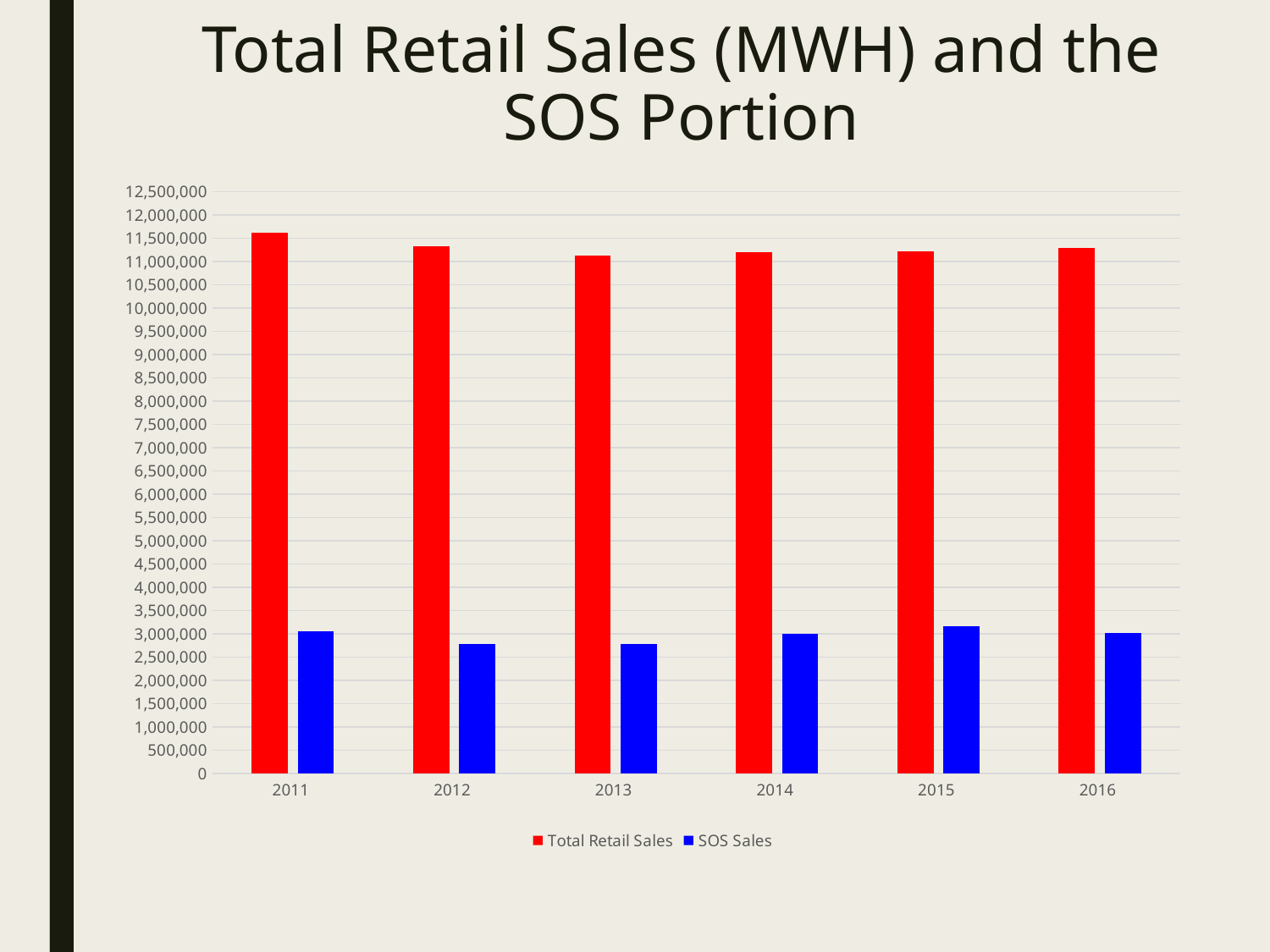
Which is larger, Total Retail Sales in 2011 or Total Retail Sales in 2013? 2011 Is the value for SOS Sales in 2015 greater or less than 3,000,000? greater Is the value for Total Retail Sales in 2013 greater or less than 10,500,000? greater Which year has the highest Total Retail Sales? 2011 Do Total Retail Sales rise or fall from 2011 to 2013? fall Is the value for SOS Sales in 2012 greater or less than 3,000,000? less Which colour represents SOS Sales in the chart? Blue How many years are shown on the x axis? 6 What kind of chart is shown on the slide? Bar chart Which is larger, SOS Sales in 2015 or SOS Sales in 2012? 2015 How many series does the legend list? 2